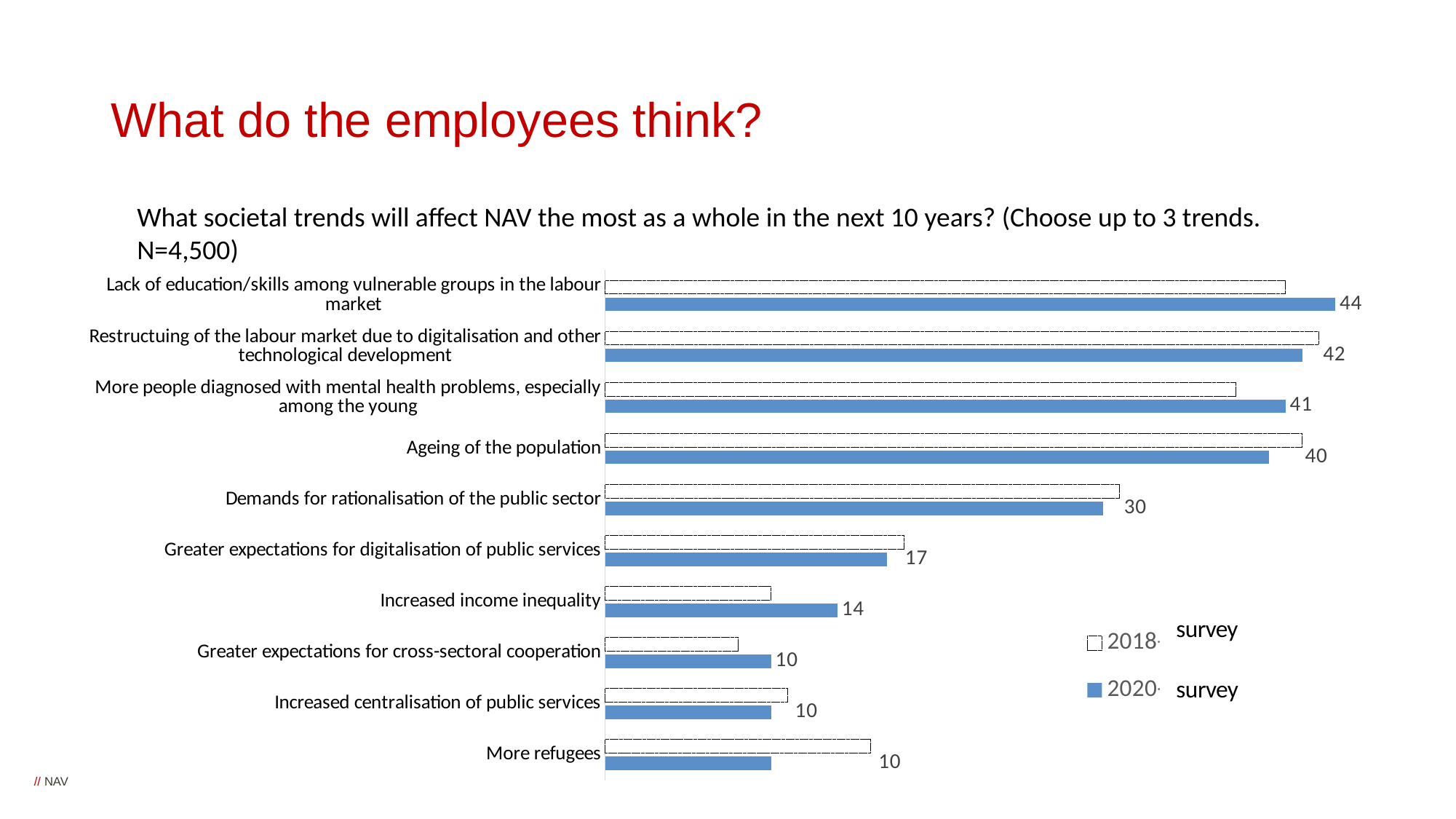
What kind of chart is shown on the slide? bar chart How many series does the legend list? 2 What is the difference between the 2020 survey values for 'Restructuing of the labour market due to digitalisation and other technological development' and 'More people diagnosed with mental health problems, especially among the young'? 1 For 'More refugees', which survey has the larger value, 2018 or 2020? 2018 How many societal trends (categories) are shown in the chart? 10 For 'Increased income inequality', which survey has the larger value, 2018 or 2020? 2020 What is the difference between the 2020 survey values for 'Demands for rationalisation of the public sector' and 'Increased income inequality'? 16 What is the 2020 survey value for 'Lack of education/skills among vulnerable groups in the labour market'? 44 Which trend has the highest 2020 survey value? Lack of education/skills among vulnerable groups in the labour market What is the 2020 survey value for 'Greater expectations for digitalisation of public services'? 17 What is the 2020 survey value for 'Ageing of the population'? 40 Which series is drawn with solid blue bars? 2020 survey